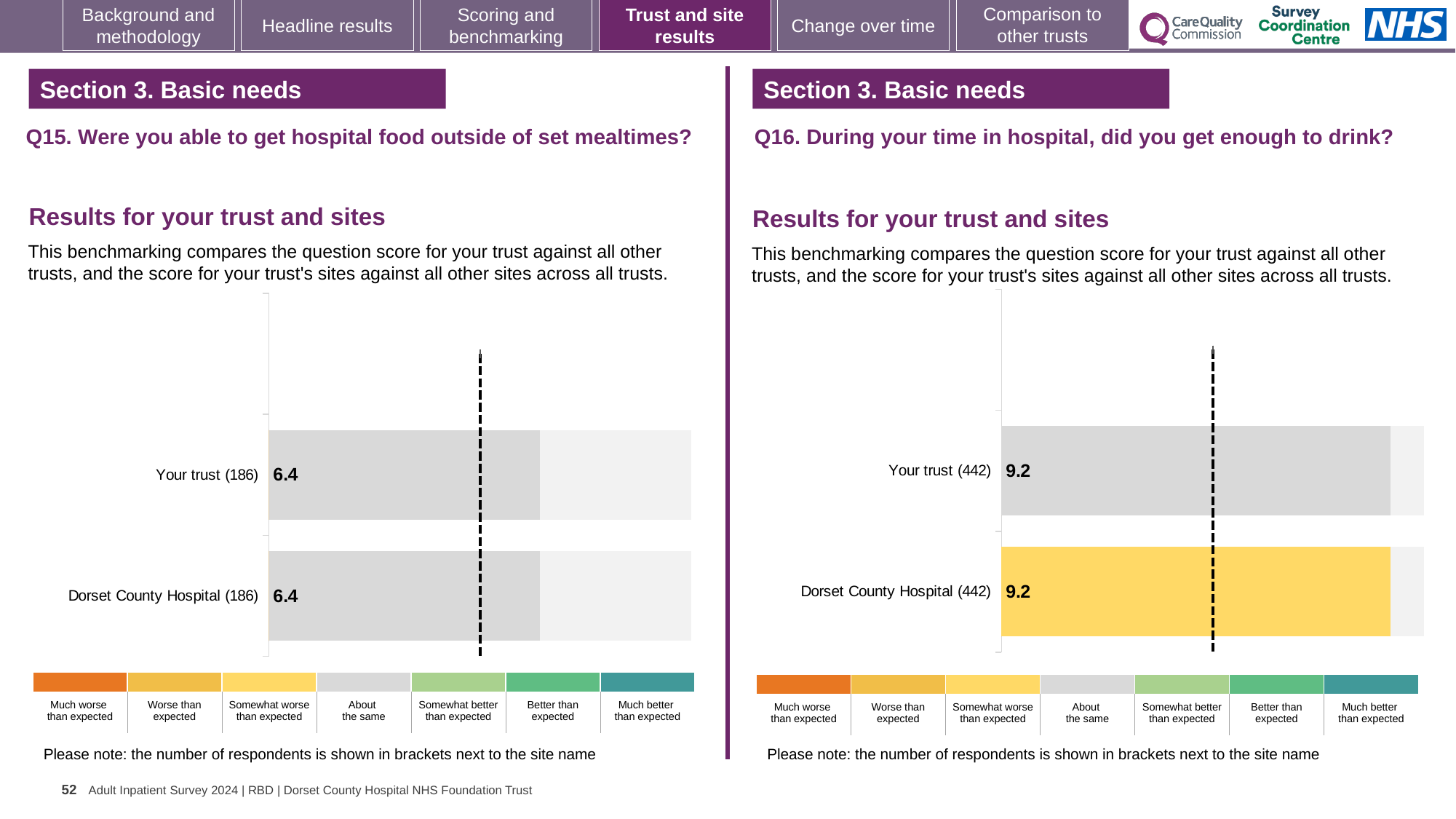
In the Q15 chart on the left, how many respondents are shown in brackets next to Dorset County Hospital? 186 In the Q15 chart on the left, what is the score for Your trust? 6.4 In the Q16 chart on the right, what is the difference between the score for Your trust and the score for Dorset County Hospital? 0 In the Q16 chart on the right, how many respondents are shown in brackets next to Your trust? 442 In the Q16 chart on the right, which benchmark category does the colour of the Dorset County Hospital bar correspond to? Somewhat worse than expected How many bars are plotted in the Q15 chart on the left? 2 In the Q15 chart on the left, what is the score for Dorset County Hospital? 6.4 In the Q16 chart on the right, what is the score for Your trust? 9.2 How many bars are plotted in the Q16 chart on the right? 2 What kind of chart is the Q16 chart on the right? Bar chart In the Q15 chart on the left, what is the difference between the score for Your trust and the score for Dorset County Hospital? 0 In the Q16 chart on the right, what is the score for Dorset County Hospital? 9.2